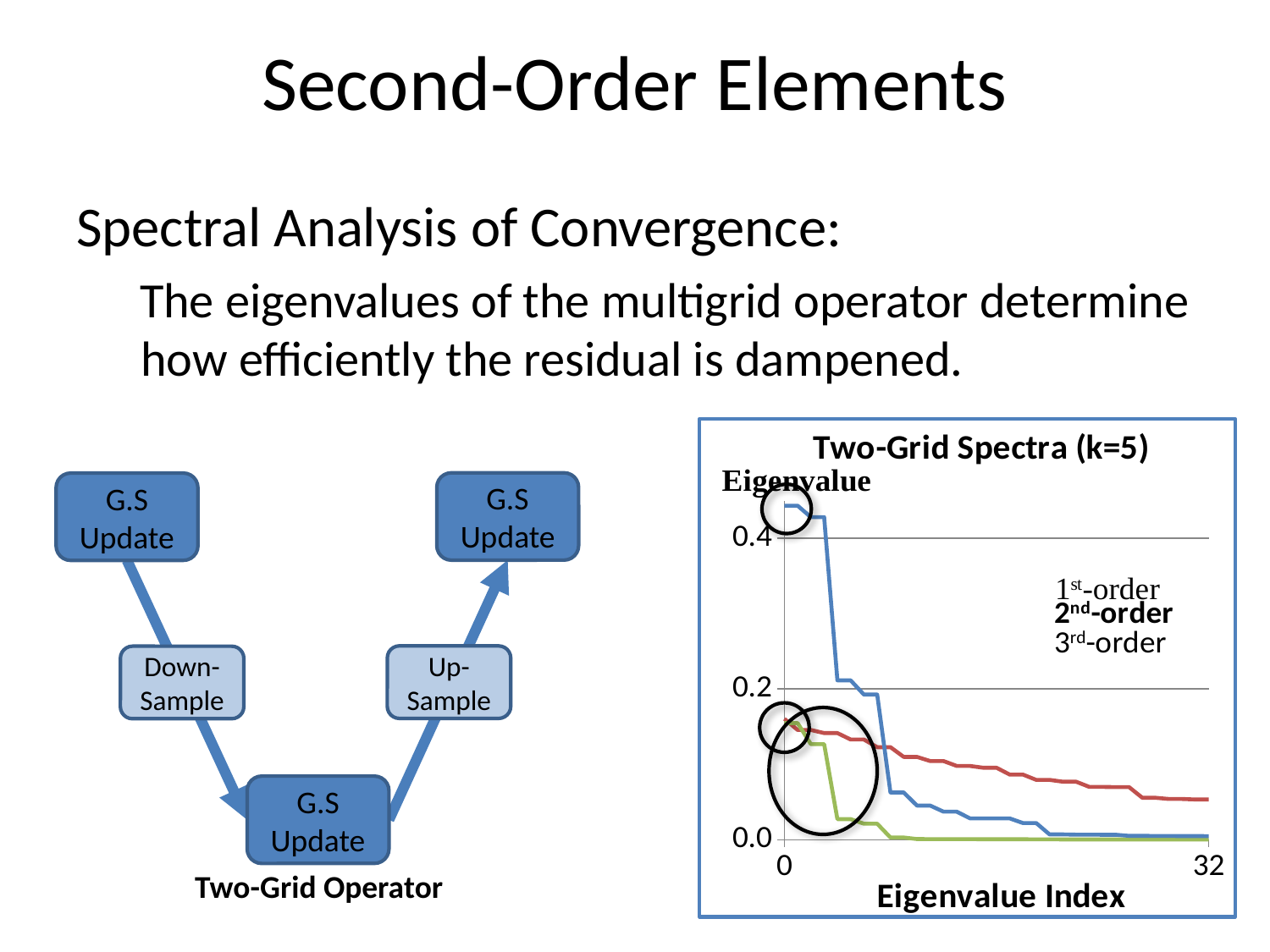
How many series does the chart's legend list? 3 What type of chart is shown on the slide? line chart Is the value of the blue line at eigenvalue index 0 greater or less than 0.4? greater At eigenvalue index 32, which line is higher, the red line or the green line? red line Is the value of the red line at eigenvalue index 32 greater or less than 0.2? less What is the title of the chart? Two-Grid Spectra (k=5) What is the largest value shown on the x axis of the chart? 32 Does the red line rise or fall as the eigenvalue index increases? fall Is the value of the green line at eigenvalue index 32 greater or less than 0.2? less What is the label of the x axis of the chart? Eigenvalue Index Does the blue line rise or fall as the eigenvalue index increases? fall Which line has the highest value at eigenvalue index 0? blue line